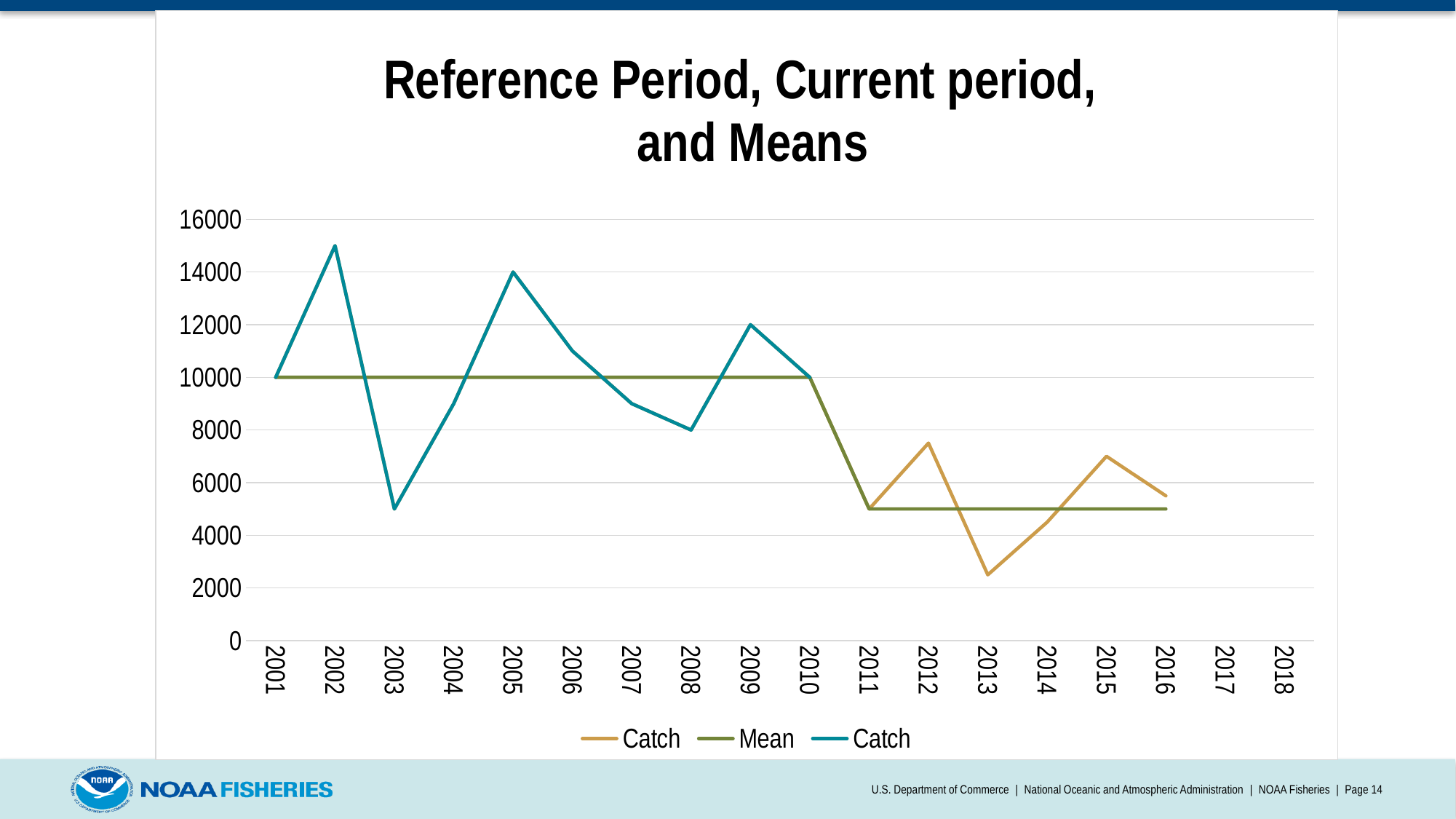
What kind of chart is shown on the slide? line chart In which year does the orange Catch line reach its lowest value? 2013 What is the value of the teal Catch line in 2009? 12000 Does the orange Catch line rise or fall from 2012 to 2013? fall What is the value of the teal Catch line in 2005? 14000 Is the value of the orange Catch line in 2013 greater or less than 4000? less How many years are labelled along the x axis? 18 In which year does the teal Catch line reach its highest value? 2002 Is the value of the teal Catch line in 2002 greater or less than 14000? greater What is the value of the Mean line in 2001? 10000 How many series does the legend list? 3 What is the difference between the teal Catch values in 2005 and 2008? 6000